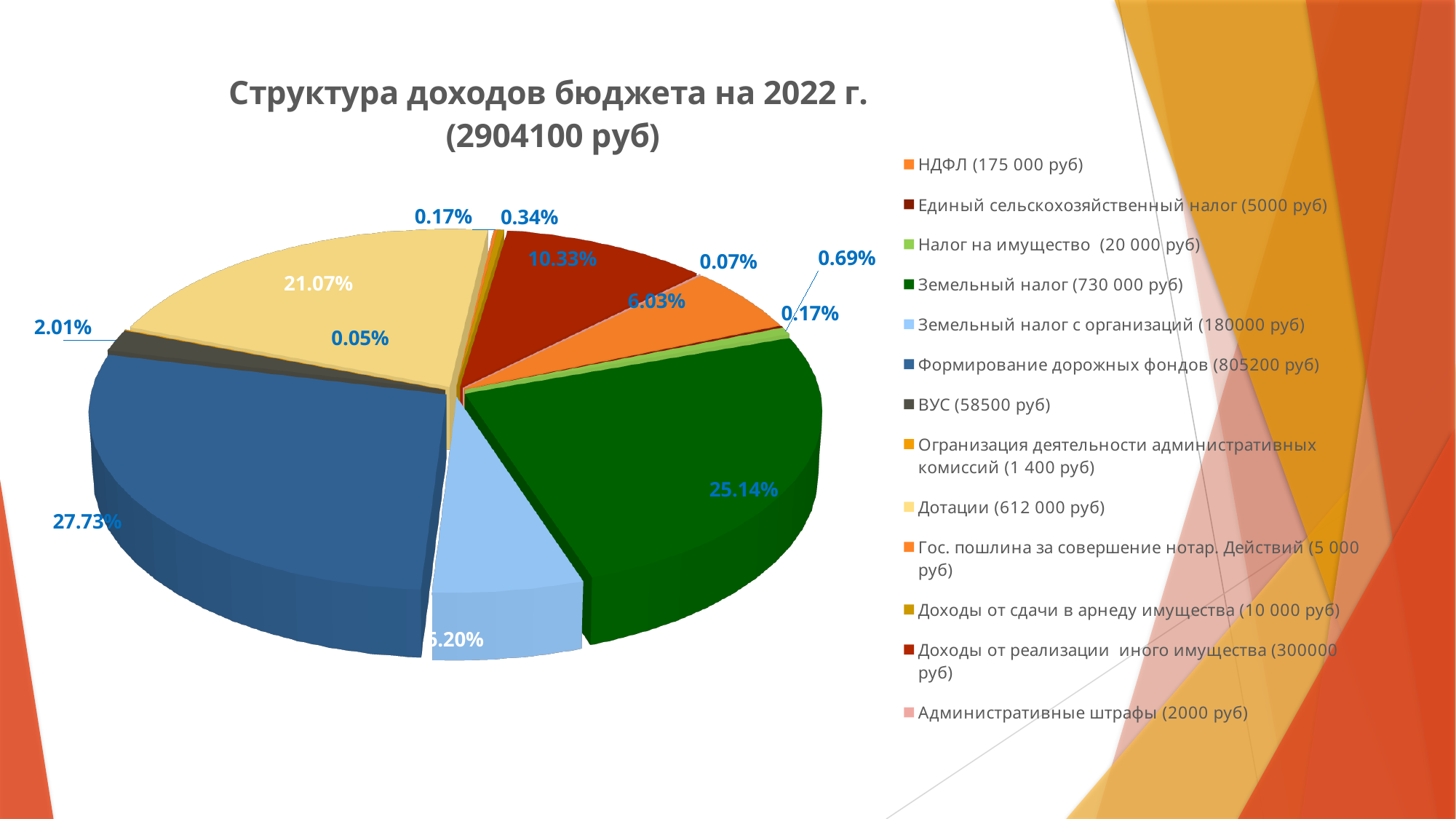
Which is larger: the share for Земельный налог or the share for Дотации? Земельный налог What share of the budget revenue does НДФЛ account for? 6.03% What is the difference in percentage points between the share for Формирование дорожных фондов and the share for Земельный налог? 2.59 How many entries does the legend of the pie chart list? 13 What share of the budget revenue does Земельный налог account for? 25.14% What total budget revenue amount is stated in the chart title? 2904100 руб What share of the budget revenue does ВУС account for? 2.01% What type of chart is shown on the slide? pie chart What share of the budget revenue does Формирование дорожных фондов account for? 27.73% Which revenue source has the largest slice of the pie? Формирование дорожных фондов (805200 руб) What share of the budget revenue does Дотации account for? 21.07% Which revenue source has the smallest slice of the pie? Огранизация деятельности административных комиссий (1 400 руб)